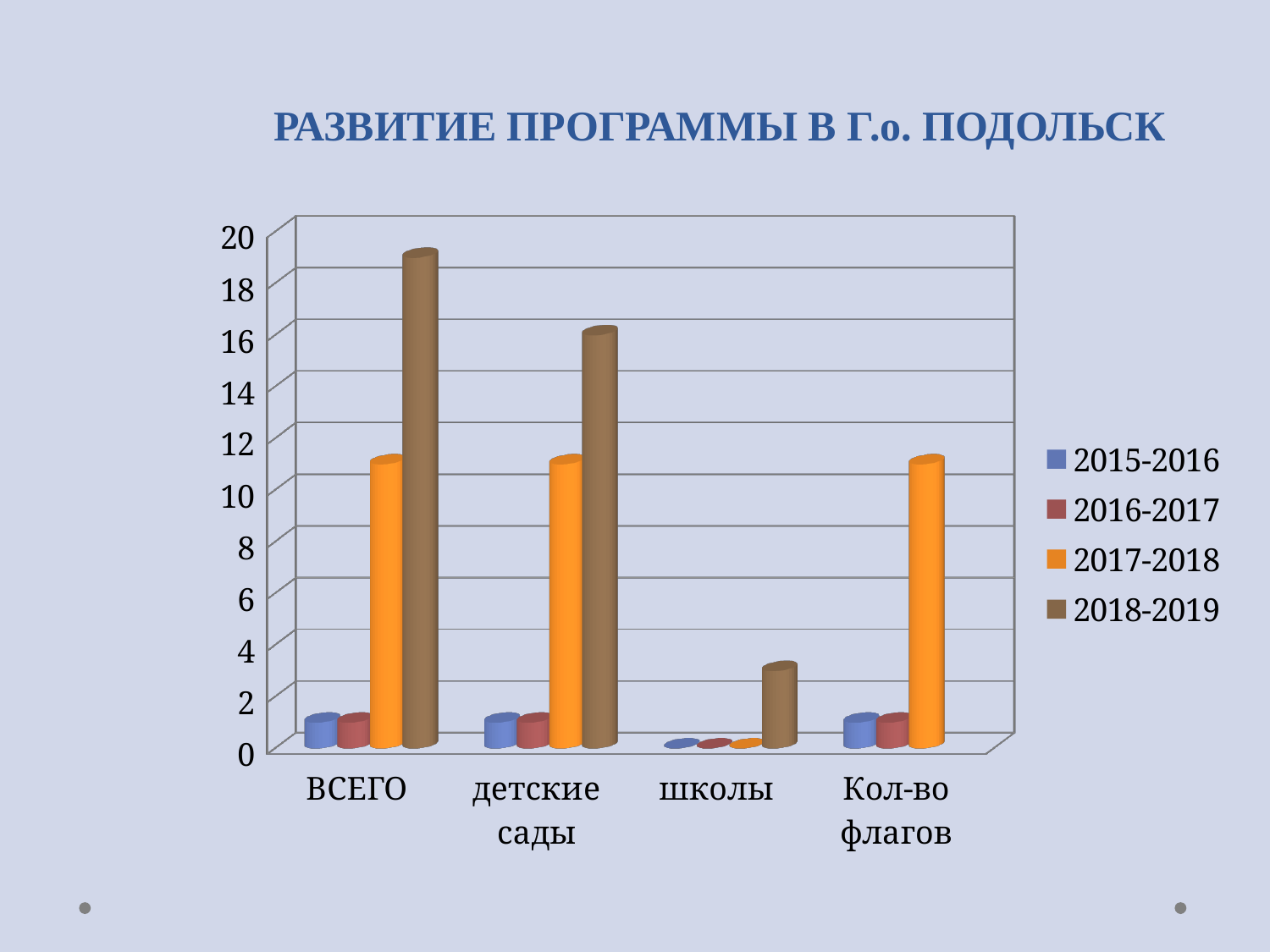
Which series has the highest value in the детские сады category? 2018-2019 Which series has the highest value in the ВСЕГО category? 2018-2019 Is the 2018-2019 value for ВСЕГО greater or less than 16? greater Is the 2018-2019 value for школы greater or less than 6? less How many categories are shown on the x axis? 4 Which is larger: the 2018-2019 value for ВСЕГО or the 2018-2019 value for детские сады? ВСЕГО Which is larger in the школы category: the 2017-2018 value or the 2018-2019 value? 2018-2019 What is the title of the chart on the slide? РАЗВИТИЕ ПРОГРАММЫ В Г.о. ПОДОЛЬСК What kind of chart is shown on the slide? bar chart How many series does the legend list? 4 Which series has the highest value in the Кол-во флагов category? 2017-2018 Is the 2018-2019 value for детские сады greater or less than 14? greater